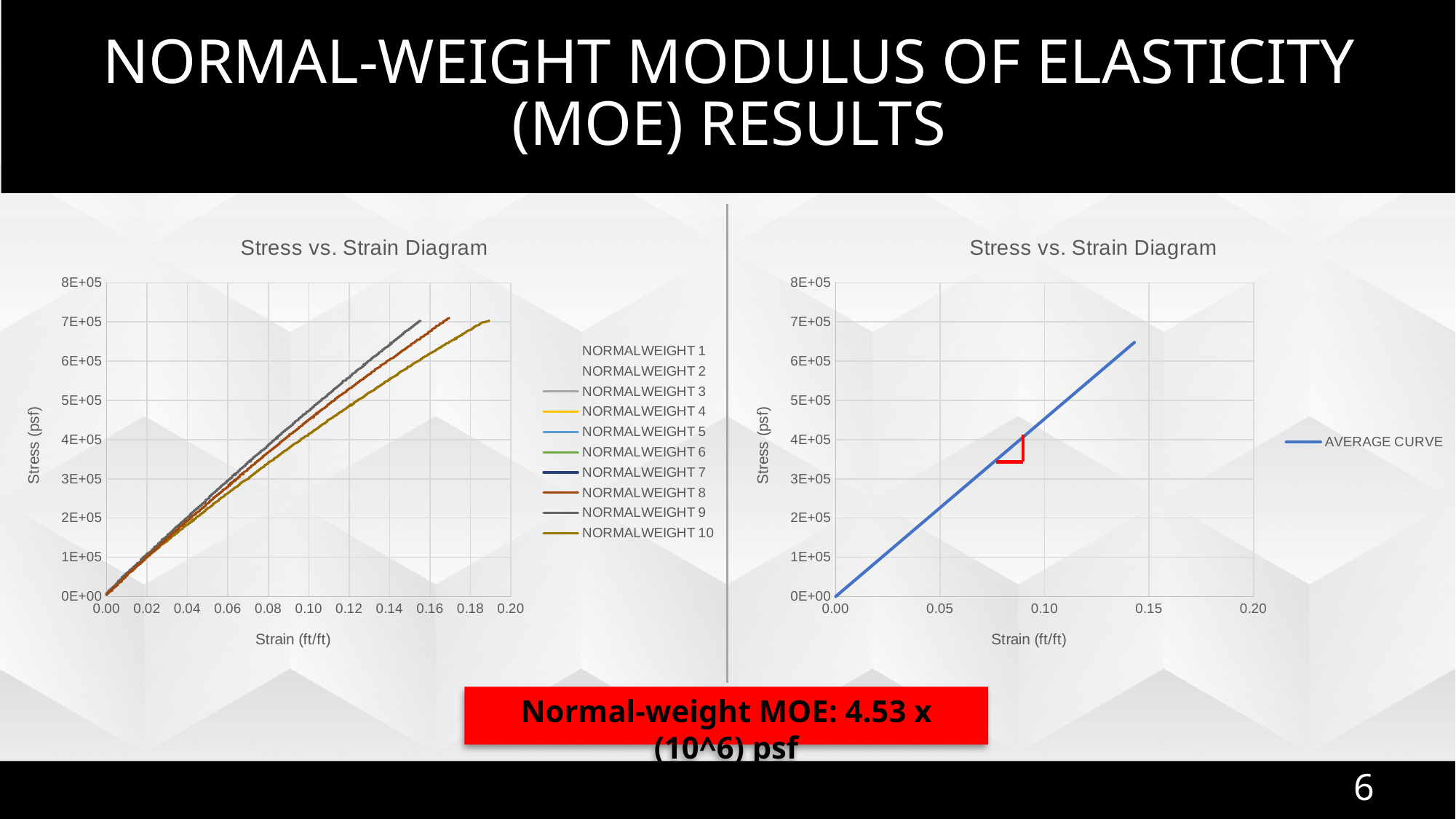
How many series does the legend of the left chart list? 10 In the right chart, is the highest stress reached by the AVERAGE CURVE greater or less than 6E+05? greater In the left chart, do the NORMALWEIGHT curves rise or fall as strain increases? Rise In the right chart, is the largest strain reached by the AVERAGE CURVE greater or less than 0.15? less In the left chart, is the largest strain reached by the NORMALWEIGHT 10 curve greater or less than 0.16? greater What is the label of the y axis on the left chart? Stress (psf) What kind of chart is the right chart titled "Stress vs. Strain Diagram"? Line chart What kind of chart is the left chart titled "Stress vs. Strain Diagram"? Line chart In the right chart, does the AVERAGE CURVE rise or fall as strain increases? Rise What is the name of the series in the legend of the right chart? AVERAGE CURVE How many series does the legend of the right chart list? 1